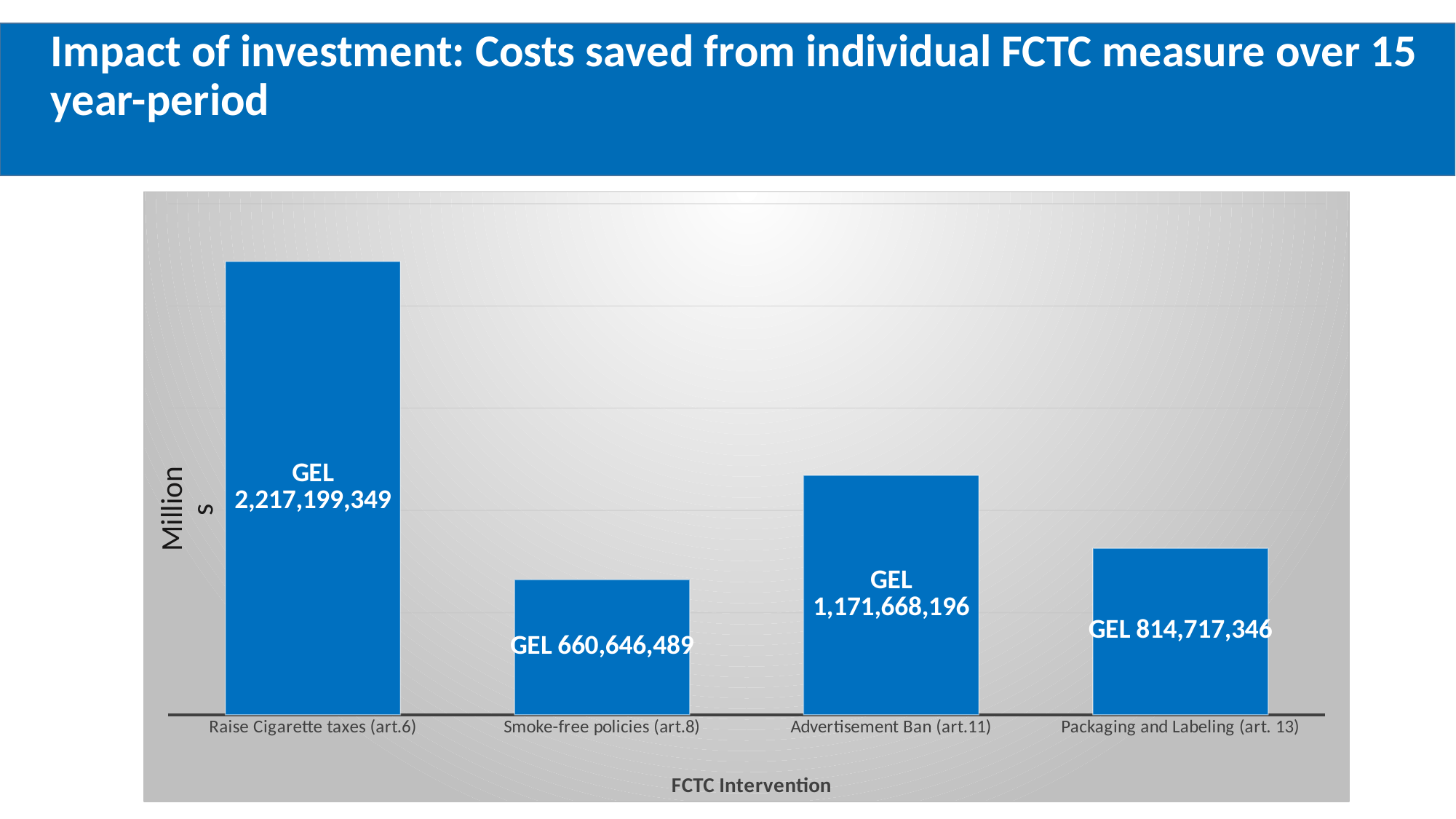
What kind of chart is shown on the slide? Bar chart What is the value for Packaging and Labeling (art. 13)? GEL 814,717,346 What is the label of the x axis? FCTC Intervention Which is larger, the value for Advertisement Ban (art.11) or Packaging and Labeling (art. 13)? Advertisement Ban (art.11) What is the value for Smoke-free policies (art.8)? GEL 660,646,489 What is the value for Raise Cigarette taxes (art.6)? GEL 2,217,199,349 What is the difference between the values for Advertisement Ban (art.11) and Packaging and Labeling (art. 13)? GEL 356,950,850 Which FCTC intervention has the lowest costs saved? Smoke-free policies (art.8) Which FCTC intervention has the highest costs saved? Raise Cigarette taxes (art.6) How many FCTC interventions are shown in the chart? 4 What is the value for Advertisement Ban (art.11)? GEL 1,171,668,196 What is the difference between the values for Raise Cigarette taxes (art.6) and Smoke-free policies (art.8)? GEL 1,556,552,860